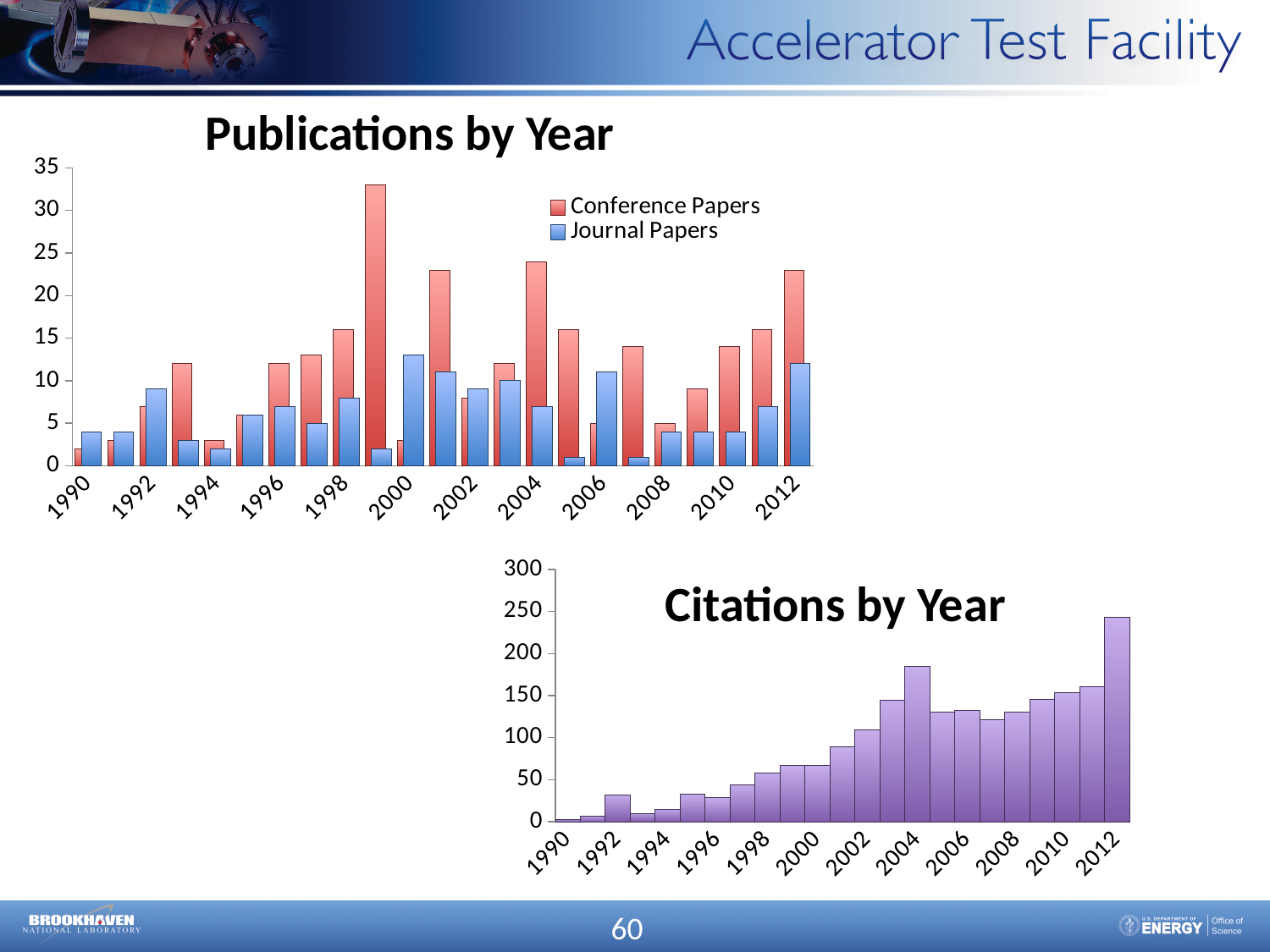
In the "Citations by Year" chart, which year has the highest number of citations? 2012 In the "Publications by Year" chart, is the value for Journal Papers in 2000 greater or less than 10? greater In the "Publications by Year" chart, what colour are the Journal Papers bars? blue In the "Citations by Year" chart, do the values generally rise or fall from 1990 to 2012? rise In the "Citations by Year" chart, which is larger: the value for 2004 or the value for 2005? 2004 What kind of chart is the "Citations by Year" chart? bar chart What kind of chart is the "Publications by Year" chart? bar chart In the "Publications by Year" chart, which year has the highest number of Conference Papers? 1999 In the "Citations by Year" chart, is the value for 2012 greater or less than 200? greater In the "Publications by Year" chart, which is larger in 1999: Conference Papers or Journal Papers? Conference Papers In the "Publications by Year" chart, is the value for Conference Papers in 1999 greater or less than 30? greater How many series does the legend of the "Publications by Year" chart list? 2